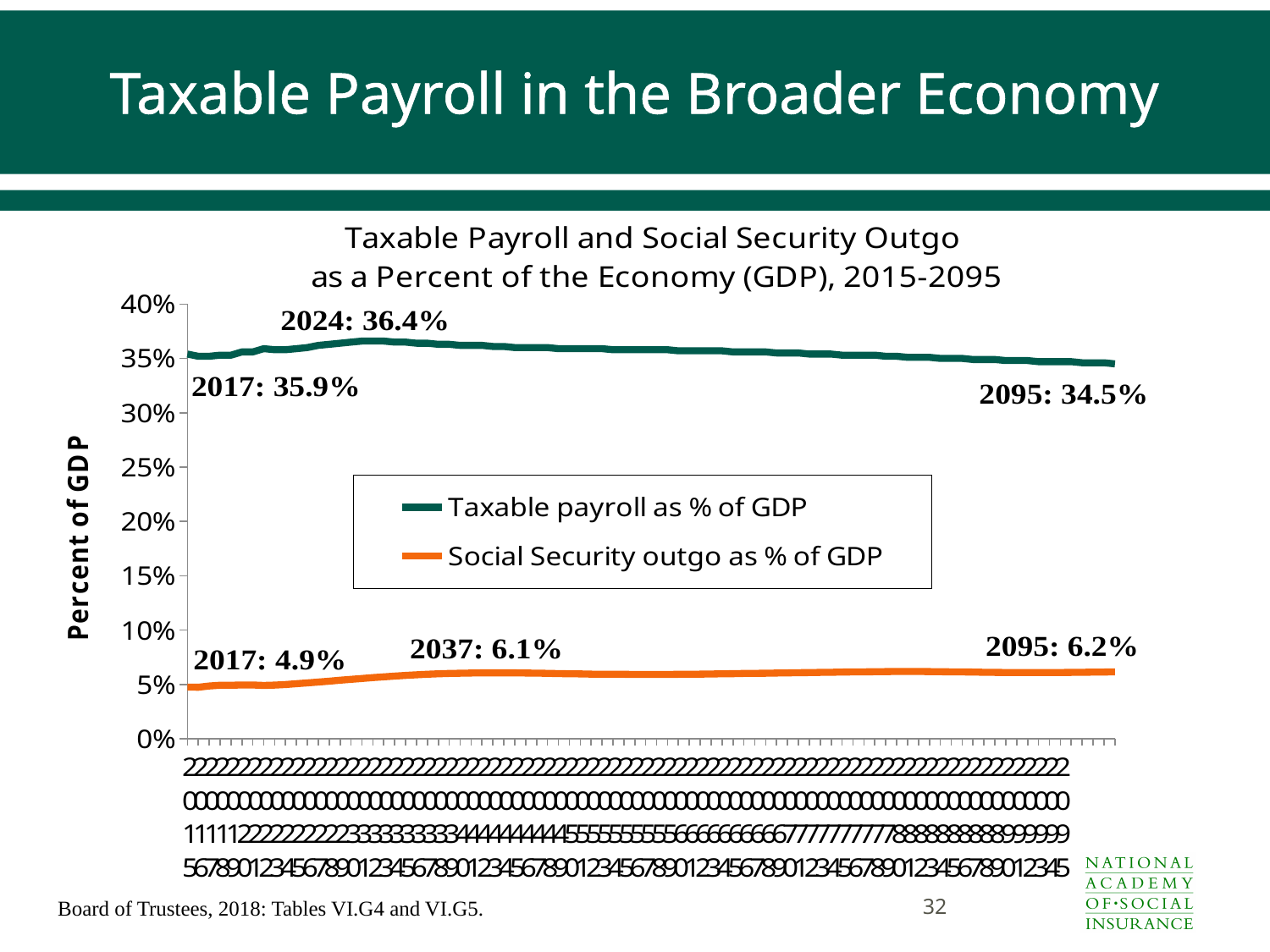
What is the value of taxable payroll as % of GDP in 2017? 35.9% Does the taxable payroll as % of GDP line rise or fall from 2024 to 2095? Fall What is the value of Social Security outgo as % of GDP in 2017? 4.9% What kind of chart is shown on the slide? Line chart What is the difference between taxable payroll as % of GDP in 2024 and in 2095? 1.9% What is the value of taxable payroll as % of GDP in 2095? 34.5% How many series does the legend list? 2 What is the value of Social Security outgo as % of GDP in 2037? 6.1% What is the value of Social Security outgo as % of GDP in 2095? 6.2% Which series is higher throughout the chart, taxable payroll as % of GDP or Social Security outgo as % of GDP? Taxable payroll as % of GDP What is the difference between Social Security outgo as % of GDP in 2095 and in 2017? 1.3% What is the value of taxable payroll as % of GDP in 2024? 36.4%